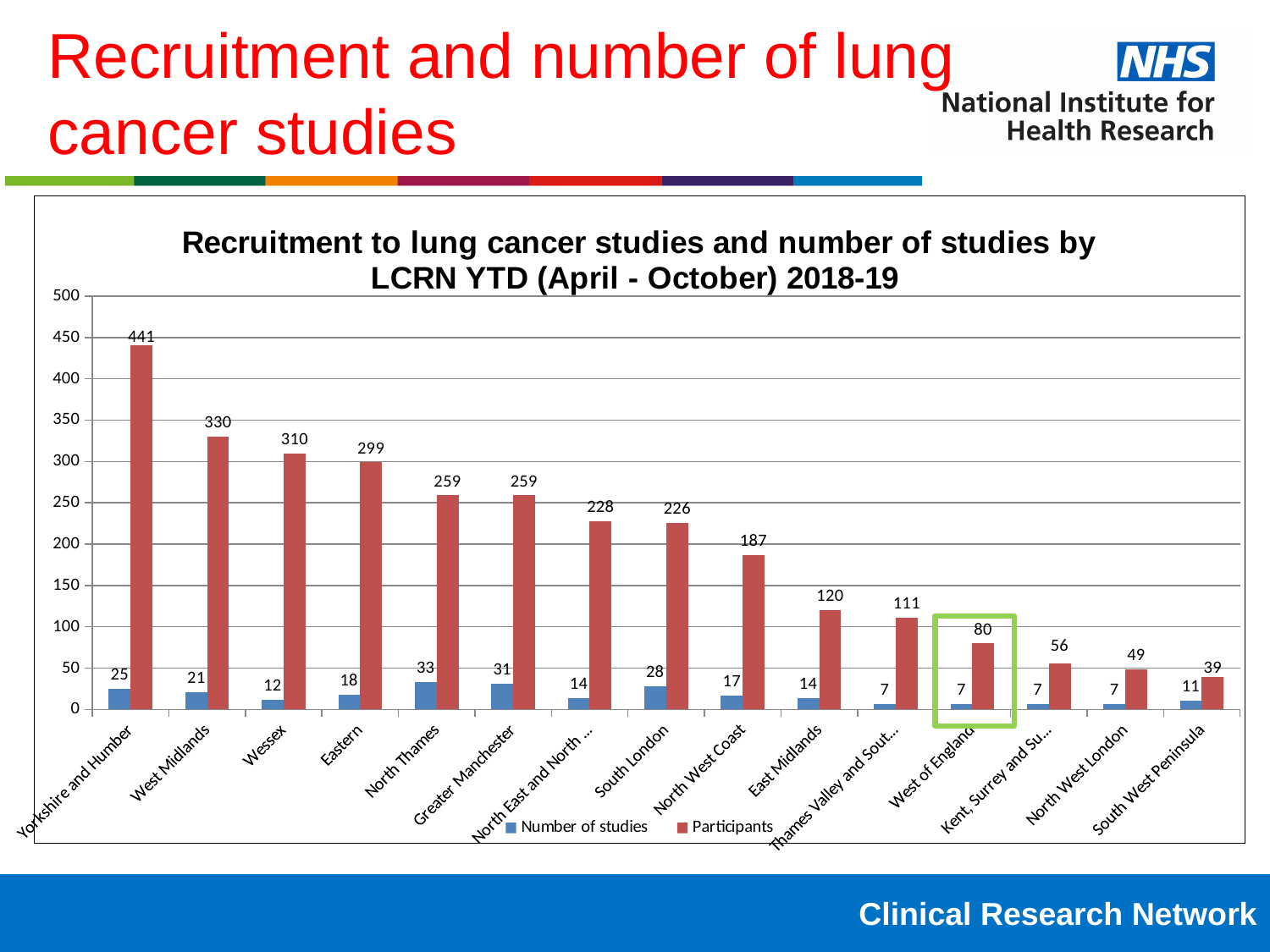
Which LCRN has the highest number of studies? North Thames What is the difference in participants between West Midlands and Wessex? 20 How many participants were recruited in West of England? 80 How many participants were recruited in Yorkshire and Humber? 441 What kind of chart is shown? Bar chart What is the number of studies for North Thames? 33 How many series does the legend list? 2 How many LCRNs are shown on the x axis? 15 Which LCRN has the highest number of participants? Yorkshire and Humber Do the participant values rise or fall from left to right along the x axis? Fall Which LCRN has the lowest number of participants? South West Peninsula Which has more participants, South London or North West Coast? South London